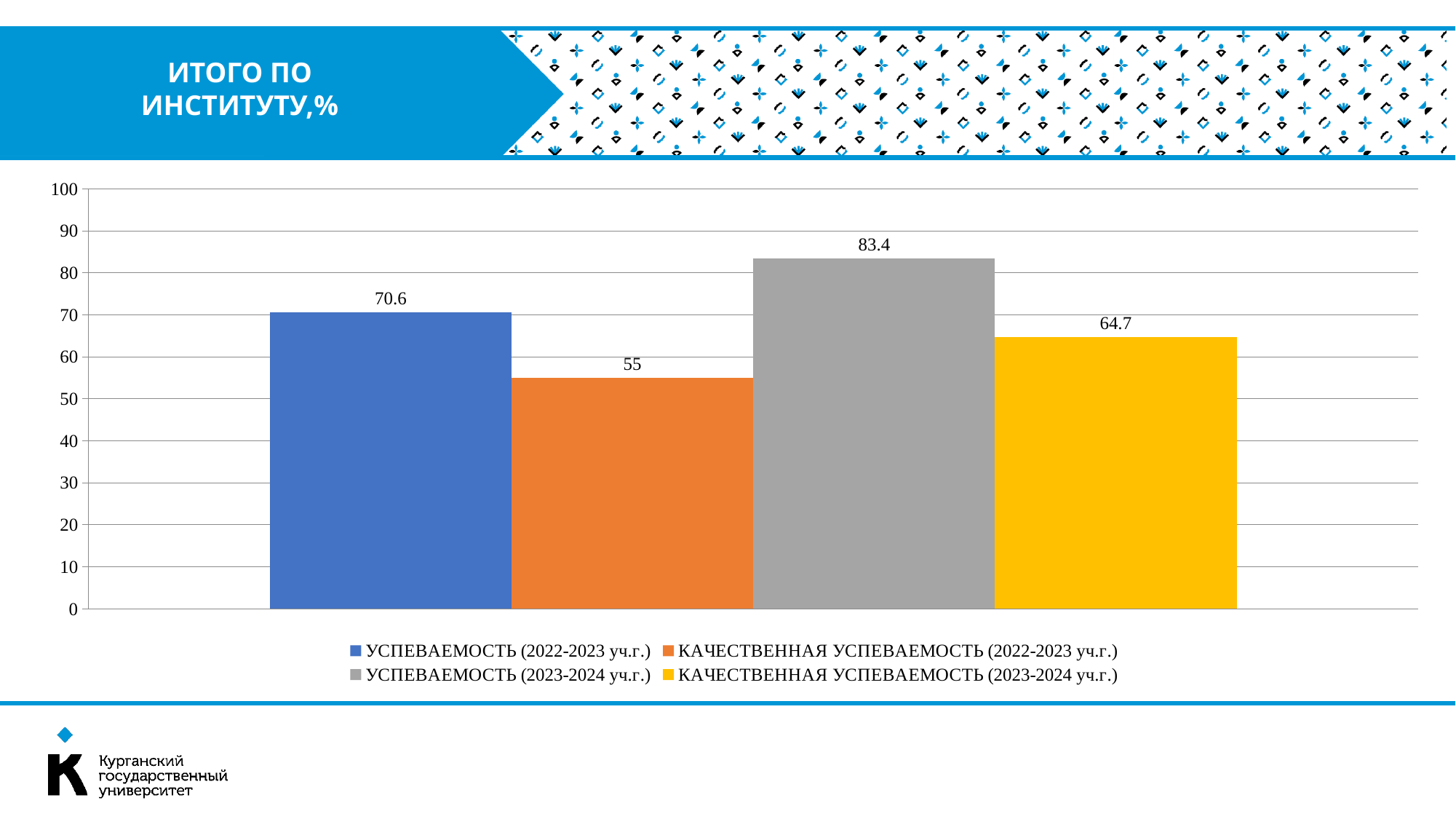
How many series does the legend list? 4 What is the value for КАЧЕСТВЕННАЯ УСПЕВАЕМОСТЬ (2023-2024 уч.г.)? 64.7 Which is larger: УСПЕВАЕМОСТЬ (2022-2023 уч.г.) or КАЧЕСТВЕННАЯ УСПЕВАЕМОСТЬ (2023-2024 уч.г.)? УСПЕВАЕМОСТЬ (2022-2023 уч.г.) What kind of chart is shown on the slide? Bar chart What is the value for УСПЕВАЕМОСТЬ (2022-2023 уч.г.)? 70.6 What is the title of the slide? ИТОГО ПО ИНСТИТУТУ,% What is the value for УСПЕВАЕМОСТЬ (2023-2024 уч.г.)? 83.4 Which series has the highest value? УСПЕВАЕМОСТЬ (2023-2024 уч.г.) What is the difference between УСПЕВАЕМОСТЬ (2023-2024 уч.г.) and УСПЕВАЕМОСТЬ (2022-2023 уч.г.)? 12.8 What is the value for КАЧЕСТВЕННАЯ УСПЕВАЕМОСТЬ (2022-2023 уч.г.)? 55 What is the difference between КАЧЕСТВЕННАЯ УСПЕВАЕМОСТЬ (2023-2024 уч.г.) and КАЧЕСТВЕННАЯ УСПЕВАЕМОСТЬ (2022-2023 уч.г.)? 9.7 Which series has the lowest value? КАЧЕСТВЕННАЯ УСПЕВАЕМОСТЬ (2022-2023 уч.г.)